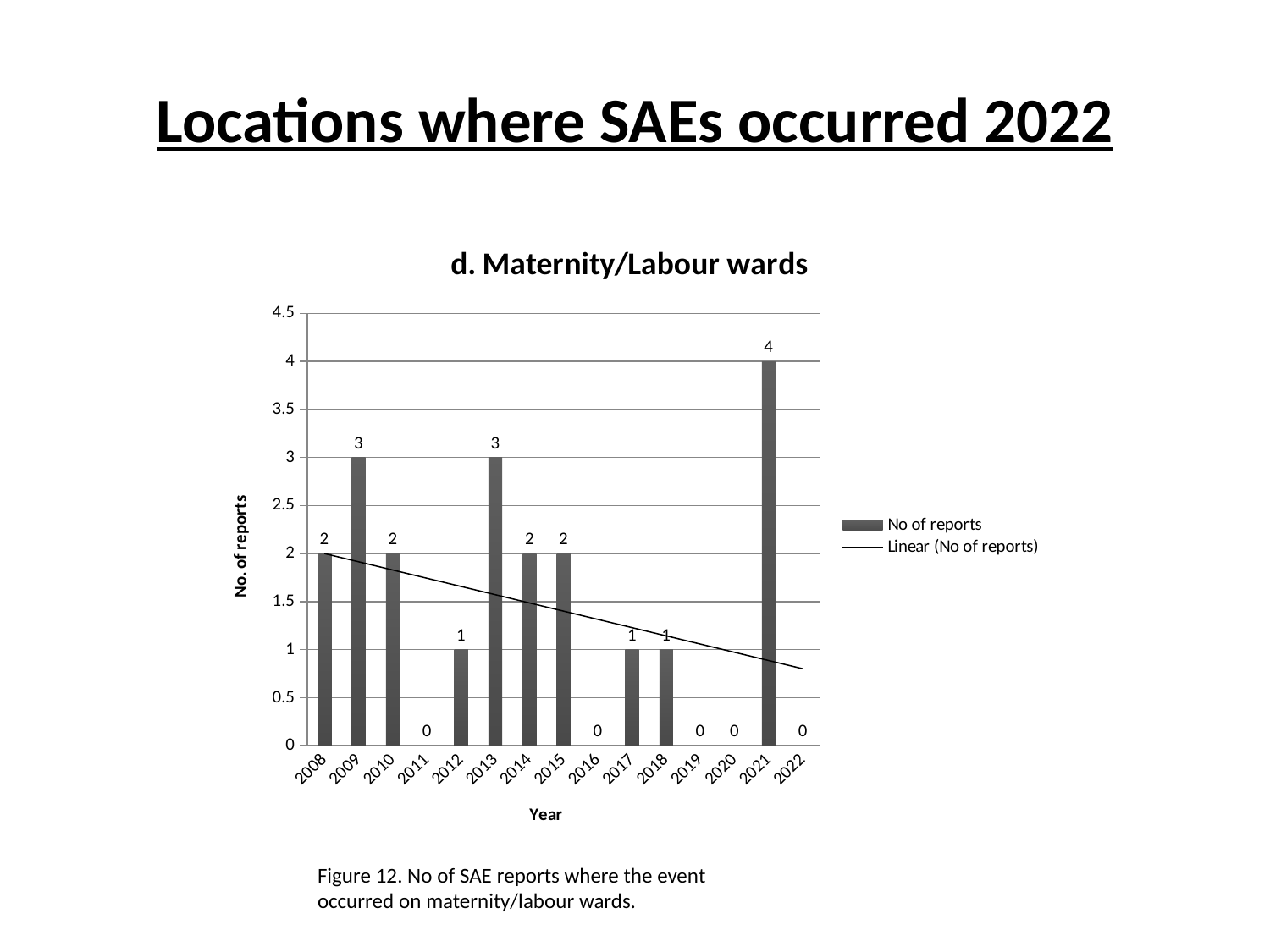
How many years are shown on the x axis? 15 What is the title of the chart? d. Maternity/Labour wards Which year has more reports, 2013 or 2017? 2013 What is the number of reports for 2015? 2 Which year has the highest number of reports? 2021 Does the linear trend line rise or fall from 2008 to 2022? fall What kind of chart is this? bar chart How many entries does the legend list? 2 What is the label of the y axis? No. of reports What is the difference between the number of reports in 2021 and 2009? 1 What is the number of reports for 2021? 4 What is the number of reports for 2012? 1